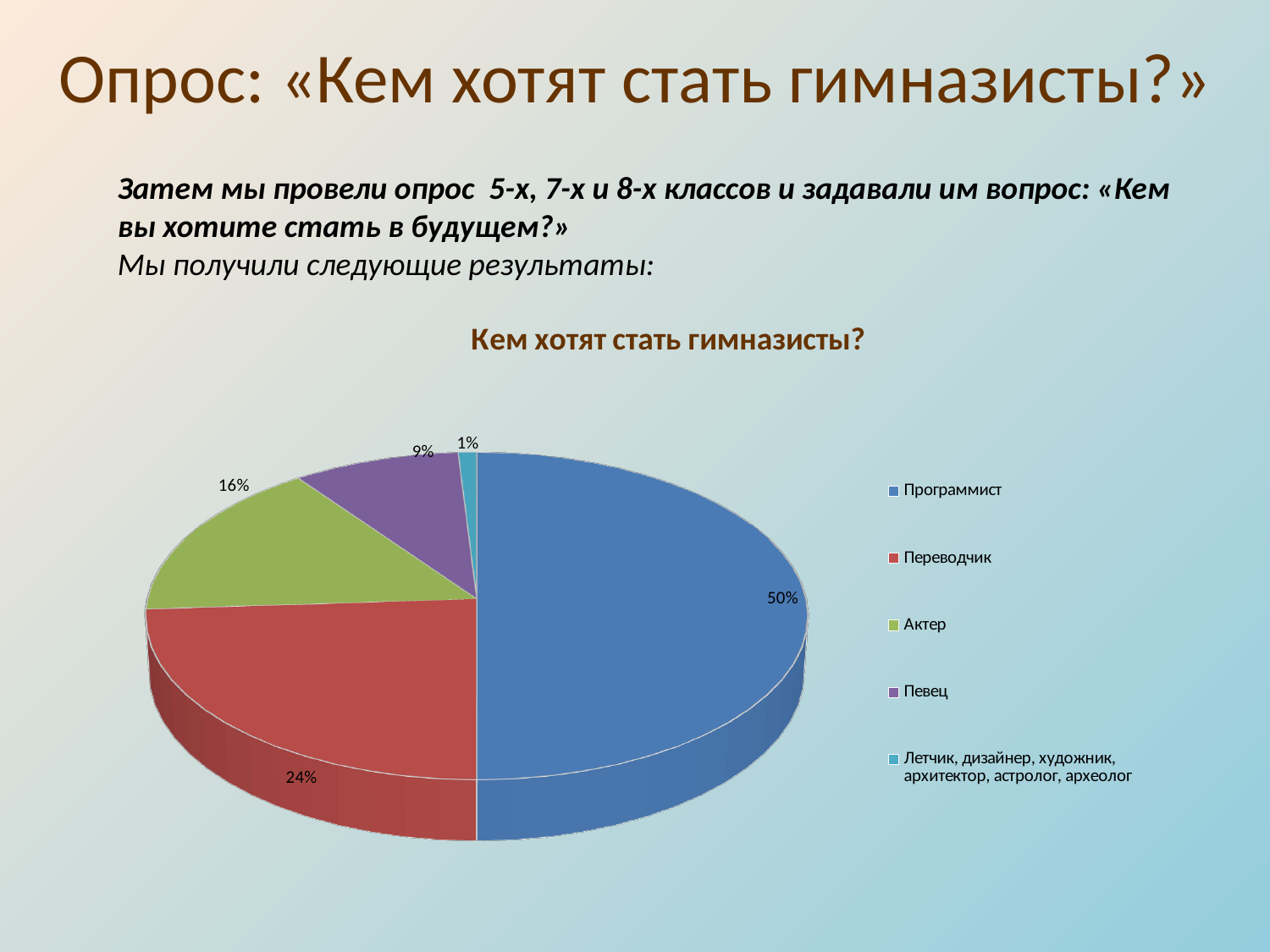
What share of the pie is labelled for the slice 'Летчик, дизайнер, художник, архитектор, астролог, археолог'? 1% What share of the pie is labelled for Программист? 50% Which category has the smallest slice of the pie? Летчик, дизайнер, художник, архитектор, астролог, археолог What is the difference in percentage points between the Программист and Переводчик slices? 26 Which category has the largest slice of the pie? Программист What share of the pie is labelled for Актер? 16% What share of the pie is labelled for Переводчик? 24% Which slice is larger, Актер or Певец? Актер How many categories does the legend list? 5 What is the title of the chart? Кем хотят стать гимназисты? What share of the pie is labelled for Певец? 9% What kind of chart is shown on the slide? pie chart